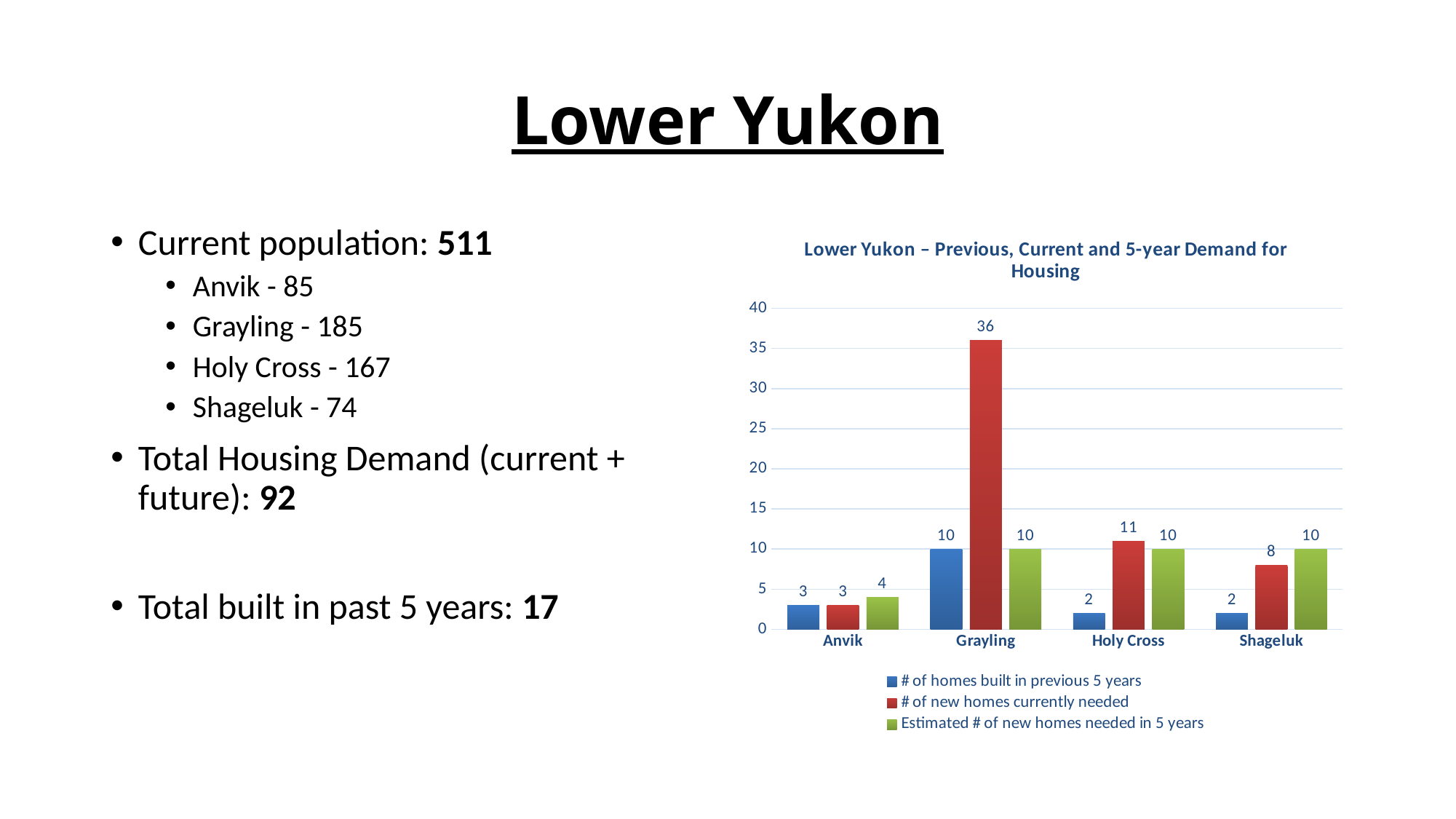
What is the difference between the number of new homes currently needed in Grayling and in Holy Cross? 25 Which community has the highest number of new homes currently needed? Grayling Is the number of new homes currently needed in Grayling greater or less than 30? greater What kind of chart is shown on the slide? Bar chart How many homes were built in the previous 5 years in Anvik? 3 What is the number of new homes currently needed in Grayling? 36 How many series does the chart legend list? 3 Which community has the lowest estimated number of new homes needed in 5 years? Anvik What is the title of the chart? Lower Yukon – Previous, Current and 5-year Demand for Housing How many communities are shown on the x axis of the chart? 4 Which is larger: the number of new homes currently needed in Holy Cross or in Shageluk? Holy Cross What is the estimated number of new homes needed in 5 years for Shageluk? 10